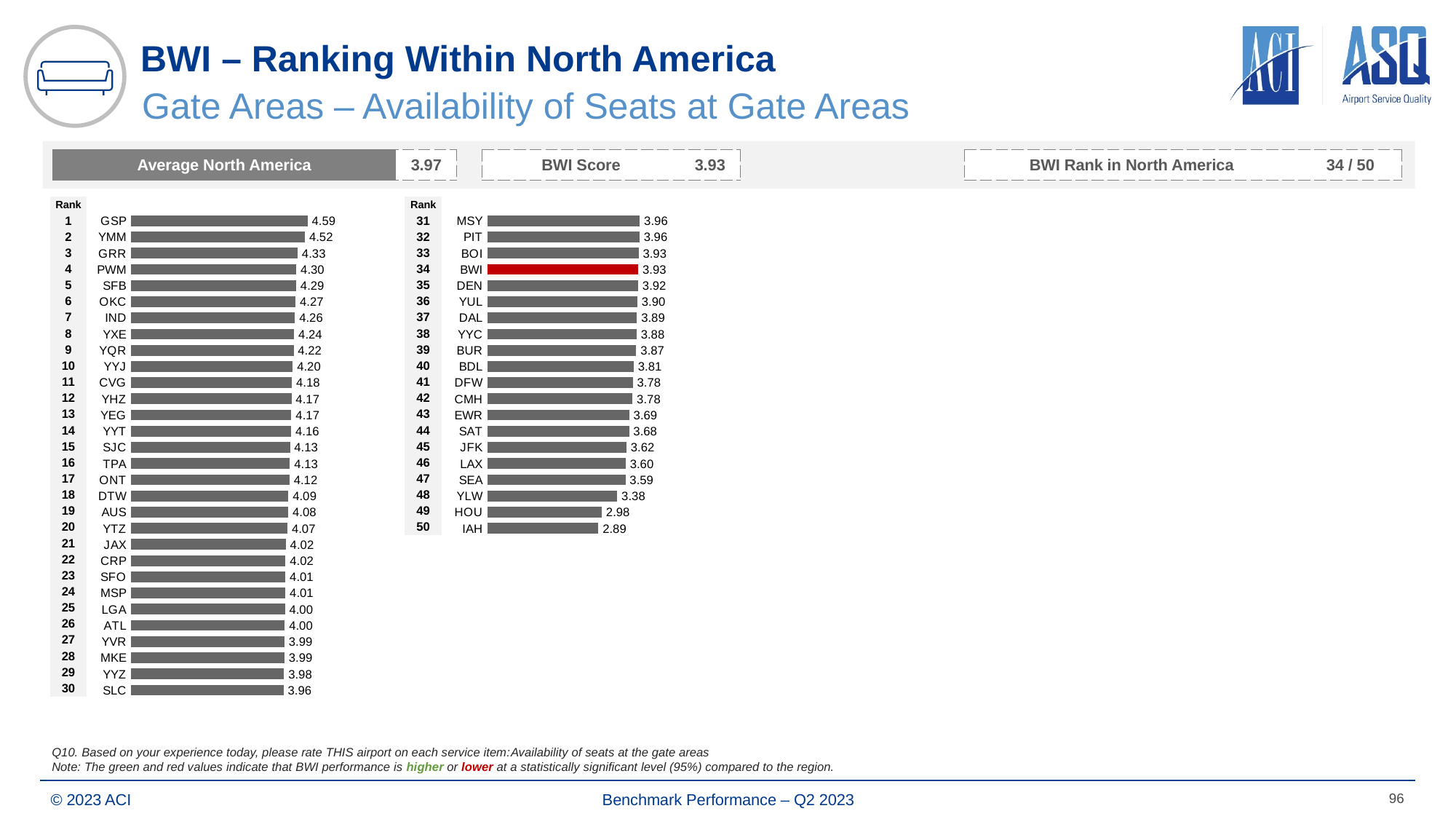
Which has the higher score, YLW or HOU? YLW Which airport's bar is highlighted in red? BWI What is the score shown for IAH? 2.89 What is the score shown for BWI in the ranking chart? 3.93 Which airport has the highest score in the ranking chart? GSP What is the difference between the Average North America score and the BWI Score? 0.04 How many airports are ranked in the chart? 50 Which airport has the lowest score in the ranking chart? IAH What kind of chart is used to show the airport rankings? Bar chart What is the difference between the scores of GSP and BWI? 0.66 What is the score shown for GSP? 4.59 Do the scores rise or fall as the rank number increases from 1 to 50? Fall